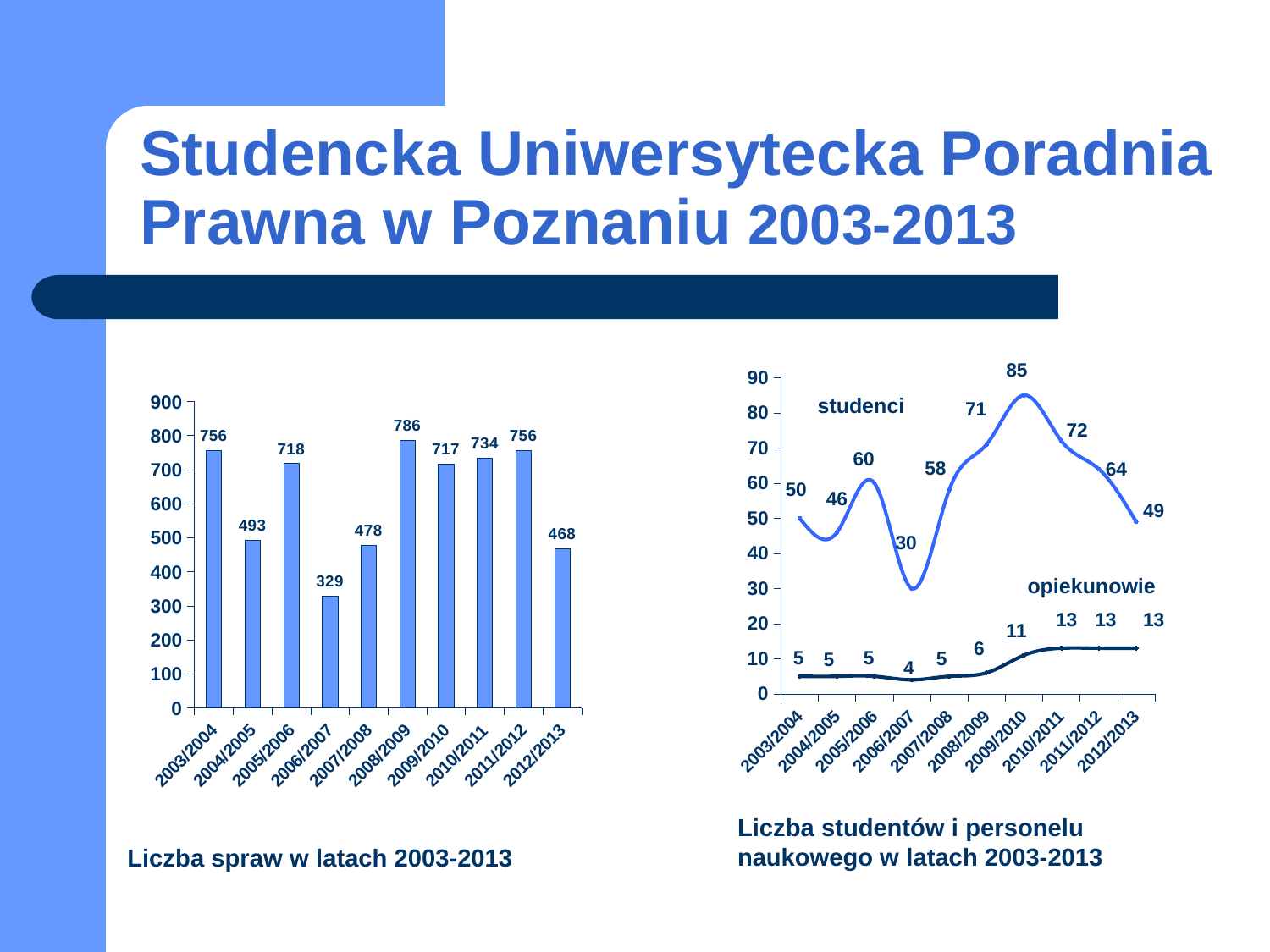
In the left chart (Liczba spraw w latach 2003-2013), what is the difference between the values for 2008/2009 and 2012/2013? 318 In the left chart (Liczba spraw w latach 2003-2013), which is larger, the value for 2004/2005 or the value for 2007/2008? 2004/2005 What kind of chart is the left chart (Liczba spraw w latach 2003-2013)? bar chart In the left chart (Liczba spraw w latach 2003-2013), which year has the lowest value? 2006/2007 In the left chart (Liczba spraw w latach 2003-2013), how many years are shown on the x axis? 10 In the left chart (Liczba spraw w latach 2003-2013), what is the value for 2006/2007? 329 In the right chart (Liczba studentów i personelu naukowego), how many series are plotted? 2 In the left chart (Liczba spraw w latach 2003-2013), which year has the highest value? 2008/2009 In the right chart (Liczba studentów i personelu naukowego), what is the value for studenci in 2009/2010? 85 In the right chart (Liczba studentów i personelu naukowego), what is the value for opiekunowie in 2006/2007? 4 In the right chart (Liczba studentów i personelu naukowego), in which year is the studenci value lowest? 2006/2007 In the right chart (Liczba studentów i personelu naukowego), what is the difference between studenci and opiekunowie in 2012/2013? 36